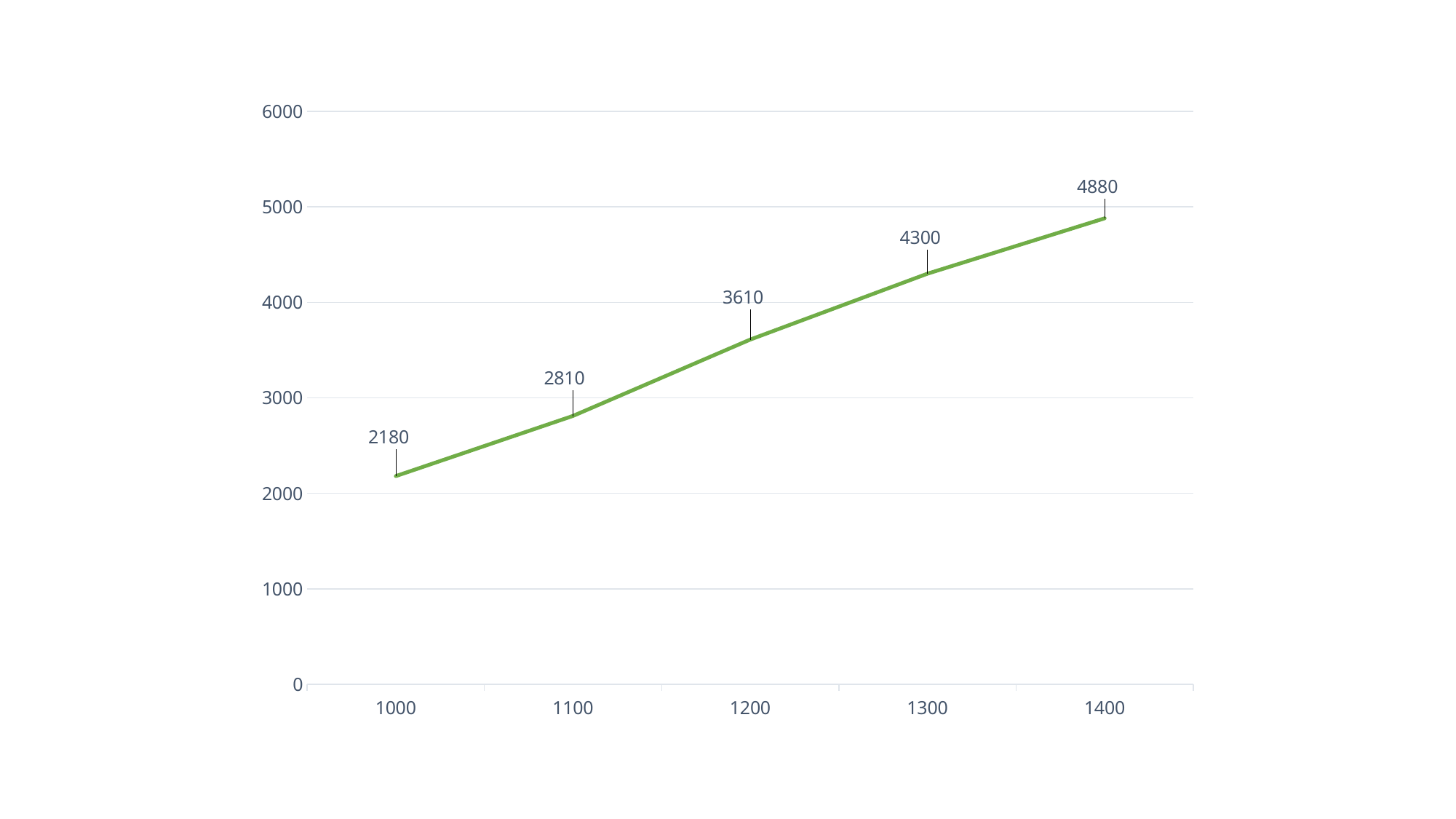
What is the difference between the values at x = 1300 and x = 1100? 1490 What kind of chart is shown on the slide? line chart What is the difference between the values at x = 1400 and x = 1000? 2700 Which is larger, the value at x = 1100 or the value at x = 1200? 1200 What is the value at x = 1200? 3610 What is the value at x = 1000? 2180 How many data points are plotted on the line? 5 Do the values rise or fall as x increases from 1000 to 1400? rise At which x value is the plotted value lowest? 1000 Is the value at x = 1300 greater or less than 4000? greater What is the value at x = 1400? 4880 At which x value is the plotted value highest? 1400